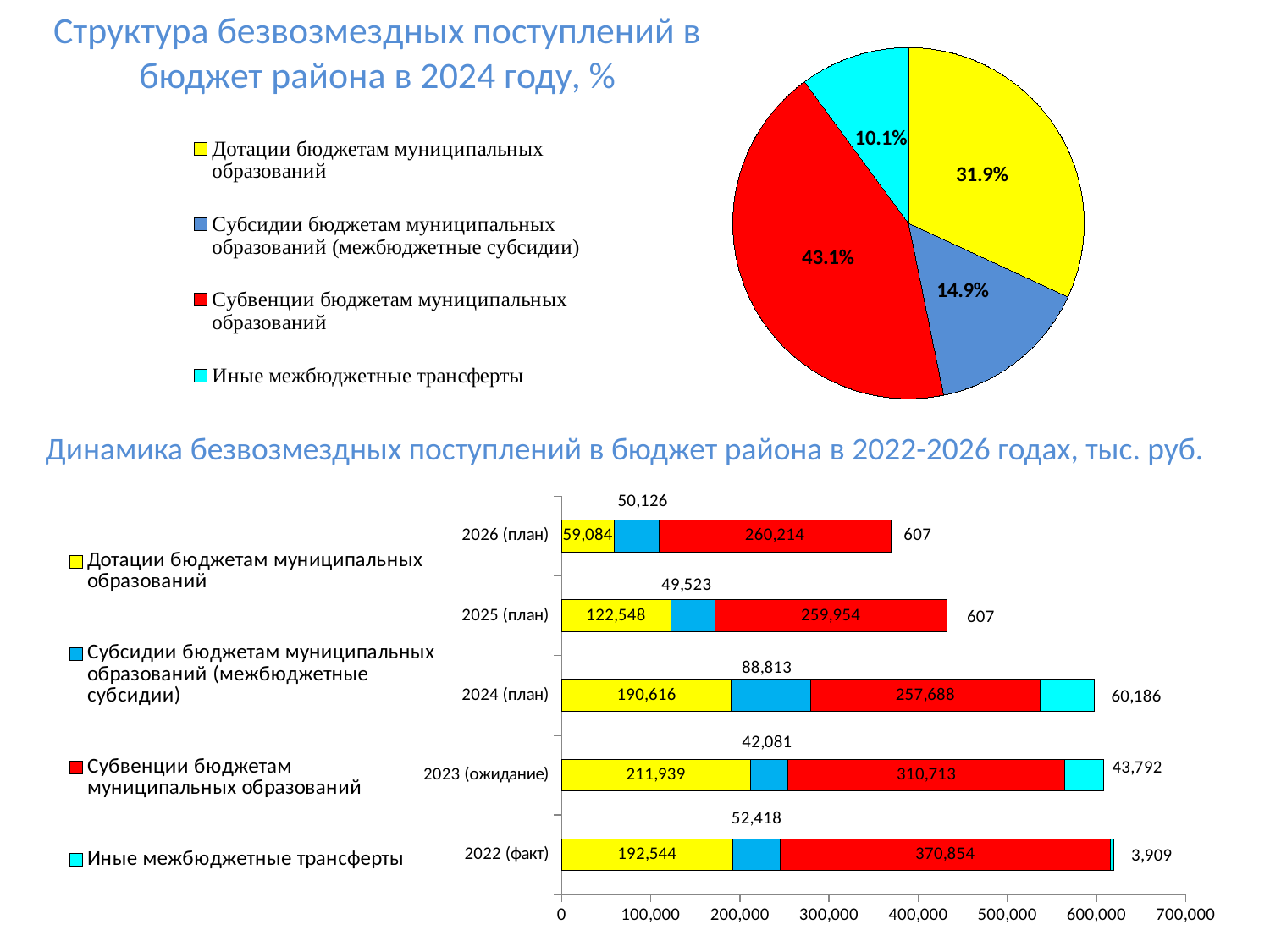
In the pie chart 'Структура безвозмездных поступлений в бюджет района в 2024 году, %', what share is shown for 'Субвенции бюджетам муниципальных образований'? 43.1% In the chart 'Динамика безвозмездных поступлений в бюджет района в 2022-2026 годах, тыс. руб.', which year has the highest value for 'Дотации бюджетам муниципальных образований'? 2023 (ожидание) In the pie chart 'Структура безвозмездных поступлений в бюджет района в 2024 году, %', how many slices are there? 4 In the chart 'Динамика безвозмездных поступлений в бюджет района в 2022-2026 годах, тыс. руб.', is the value of 'Субсидии бюджетам муниципальных образований (межбюджетные субсидии)' larger for 2024 (план) or for 2025 (план)? 2024 (план) In the chart 'Динамика безвозмездных поступлений в бюджет района в 2022-2026 годах, тыс. руб.', what is the total of the stacked bar for 2024 (план)? 597,303 In the chart 'Динамика безвозмездных поступлений в бюджет района в 2022-2026 годах, тыс. руб.', what is the value of 'Субвенции бюджетам муниципальных образований' for 2022 (факт)? 370,854 In the pie chart 'Структура безвозмездных поступлений в бюджет района в 2024 году, %', which category has the smallest share? Иные межбюджетные трансферты In the pie chart 'Структура безвозмездных поступлений в бюджет района в 2024 году, %', which category has the largest share? Субвенции бюджетам муниципальных образований In the pie chart 'Структура безвозмездных поступлений в бюджет района в 2024 году, %', what is the difference between the shares of 'Дотации бюджетам муниципальных образований' and 'Субсидии бюджетам муниципальных образований (межбюджетные субсидии)'? 17 percentage points How many series does the legend of the chart 'Динамика безвозмездных поступлений в бюджет района в 2022-2026 годах, тыс. руб.' list? 4 What kind of chart is 'Динамика безвозмездных поступлений в бюджет района в 2022-2026 годах, тыс. руб.'? Stacked bar chart In the chart 'Динамика безвозмездных поступлений в бюджет района в 2022-2026 годах, тыс. руб.', what is the value of 'Иные межбюджетные трансферты' for 2024 (план)? 60,186